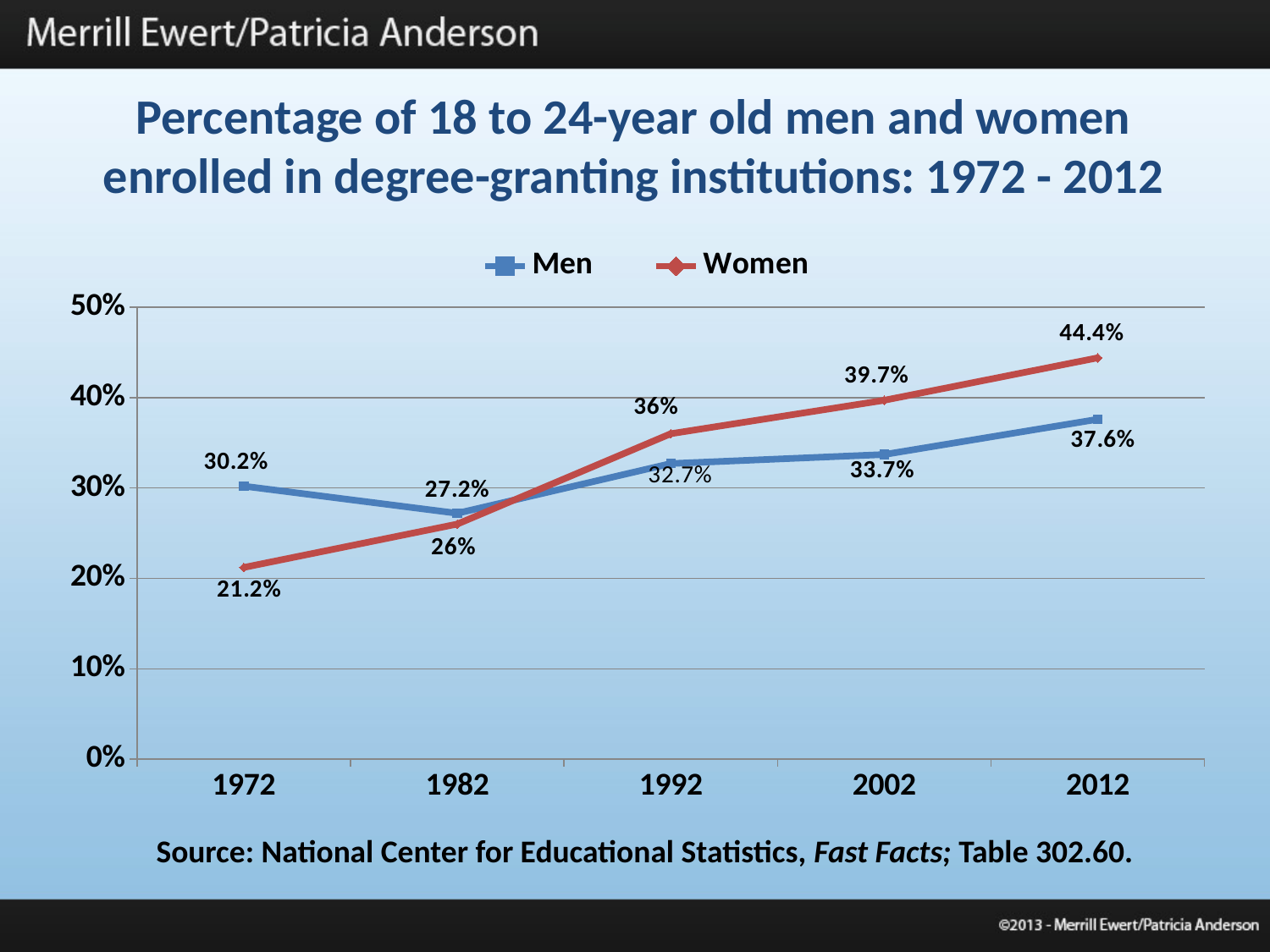
Does the value for Women rise or fall from 1972 to 2012? rise What type of chart is shown on the slide? line chart What is the value for Men in 1982? 27.2% Which is larger in 1972, the value for Men or the value for Women? Men What is the value for Women in 2012? 44.4% How many years are plotted on the x axis? 5 What colour is the line for Women? red How many series does the legend list? 2 What is the difference between the Women and Men values in 2012? 6.8% What is the value for Women in 1972? 21.2% In which year is the value for Women the highest? 2012 In which year is the value for Men the lowest? 1982